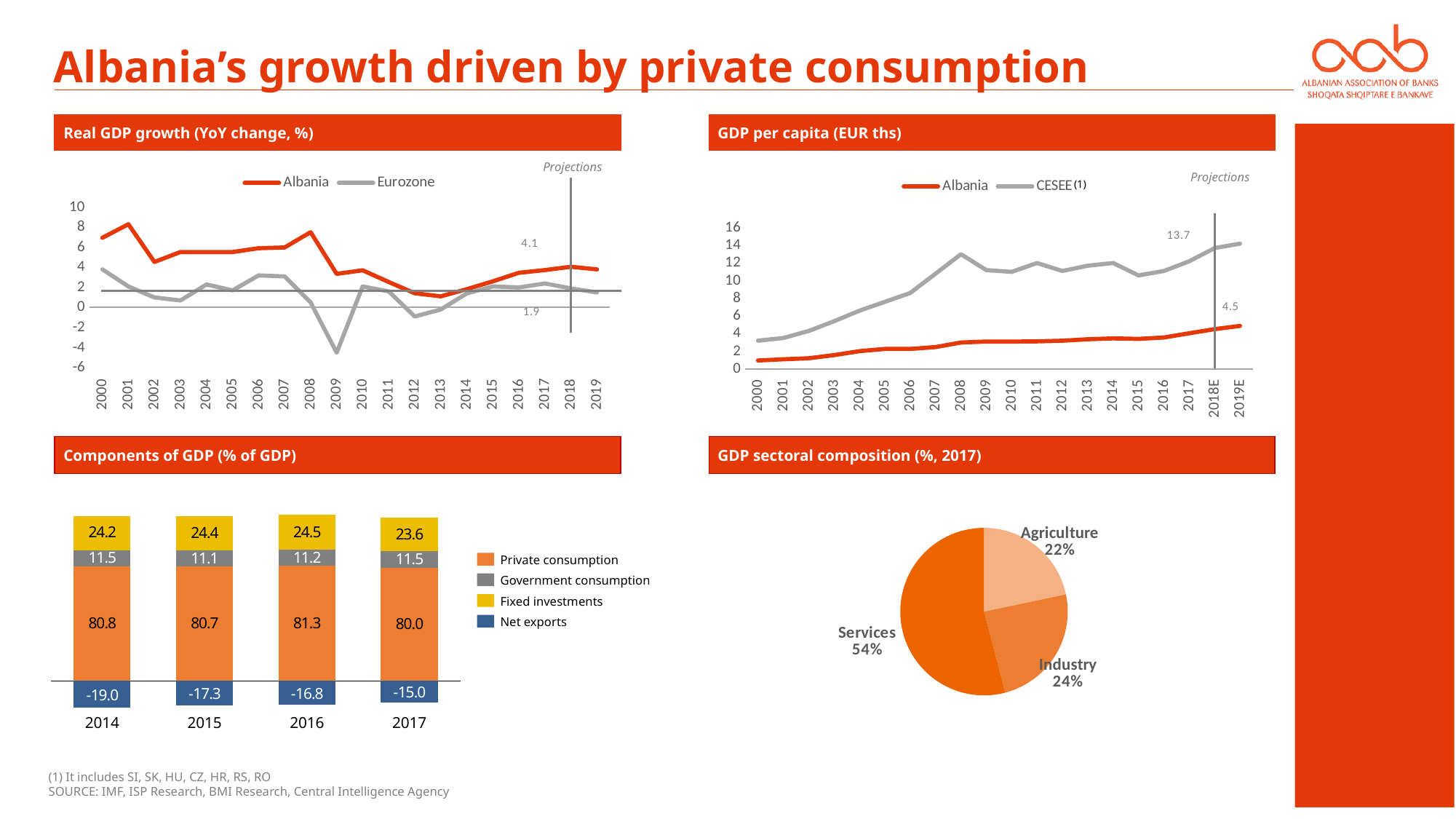
In the 'Components of GDP (% of GDP)' chart, what is the difference between Private consumption in 2016 and in 2017? 1.3 How many series does the legend of the 'Components of GDP (% of GDP)' chart list? 4 In the 'Components of GDP (% of GDP)' chart, what is the value for Fixed investments in 2017? 23.6 In the 'GDP sectoral composition (%, 2017)' chart, what share does Services have? 54% In the 'Components of GDP (% of GDP)' chart, in which year is Fixed investments highest? 2016 In the 'Components of GDP (% of GDP)' chart, what is the value for Private consumption in 2016? 81.3 In the 'Components of GDP (% of GDP)' chart, what is the value for Net exports in 2014? -19.0 What kind of chart is the 'GDP sectoral composition (%, 2017)' chart? Pie chart In the 'GDP sectoral composition (%, 2017)' chart, which sector has the smallest share? Agriculture In the 'Real GDP growth (YoY change, %)' chart, in which year is the Eurozone value lowest? 2009 In the 'GDP per capita (EUR ths)' chart, is the value for Albania in 2000 greater or less than 2? less In the 'GDP per capita (EUR ths)' chart, which is larger in 2017, Albania or CESEE? CESEE